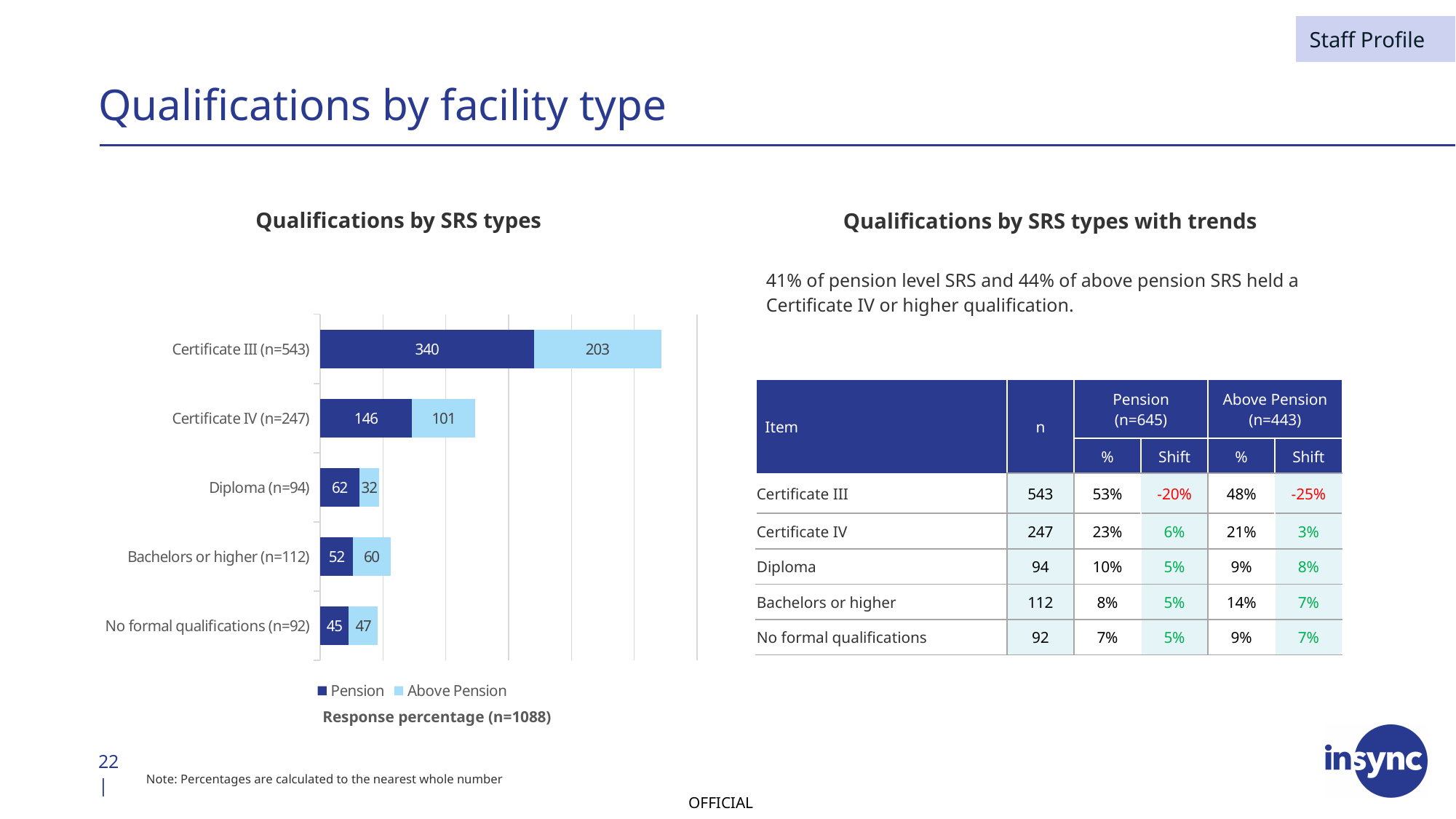
What is the Pension value for Certificate III in the Qualifications by SRS types chart? 340 What is the difference between the Pension and Above Pension values for Certificate III in the Qualifications by SRS types chart? 137 What is the Above Pension value for Certificate IV in the Qualifications by SRS types chart? 101 What is the total of the stacked bar for Certificate IV in the Qualifications by SRS types chart? 247 How many series does the legend of the Qualifications by SRS types chart list? 2 What is the Above Pension value for Diploma in the Qualifications by SRS types chart? 32 In the Qualifications by SRS types chart, is the Pension value or the Above Pension value larger for Bachelors or higher? Above Pension What kind of chart is the Qualifications by SRS types chart? Stacked bar chart Which category has the highest Pension value in the Qualifications by SRS types chart? Certificate III (n=543) How many categories are shown in the Qualifications by SRS types chart? 5 Which category has the lowest Pension value in the Qualifications by SRS types chart? No formal qualifications (n=92) What is the total of the stacked bar for No formal qualifications in the Qualifications by SRS types chart? 92